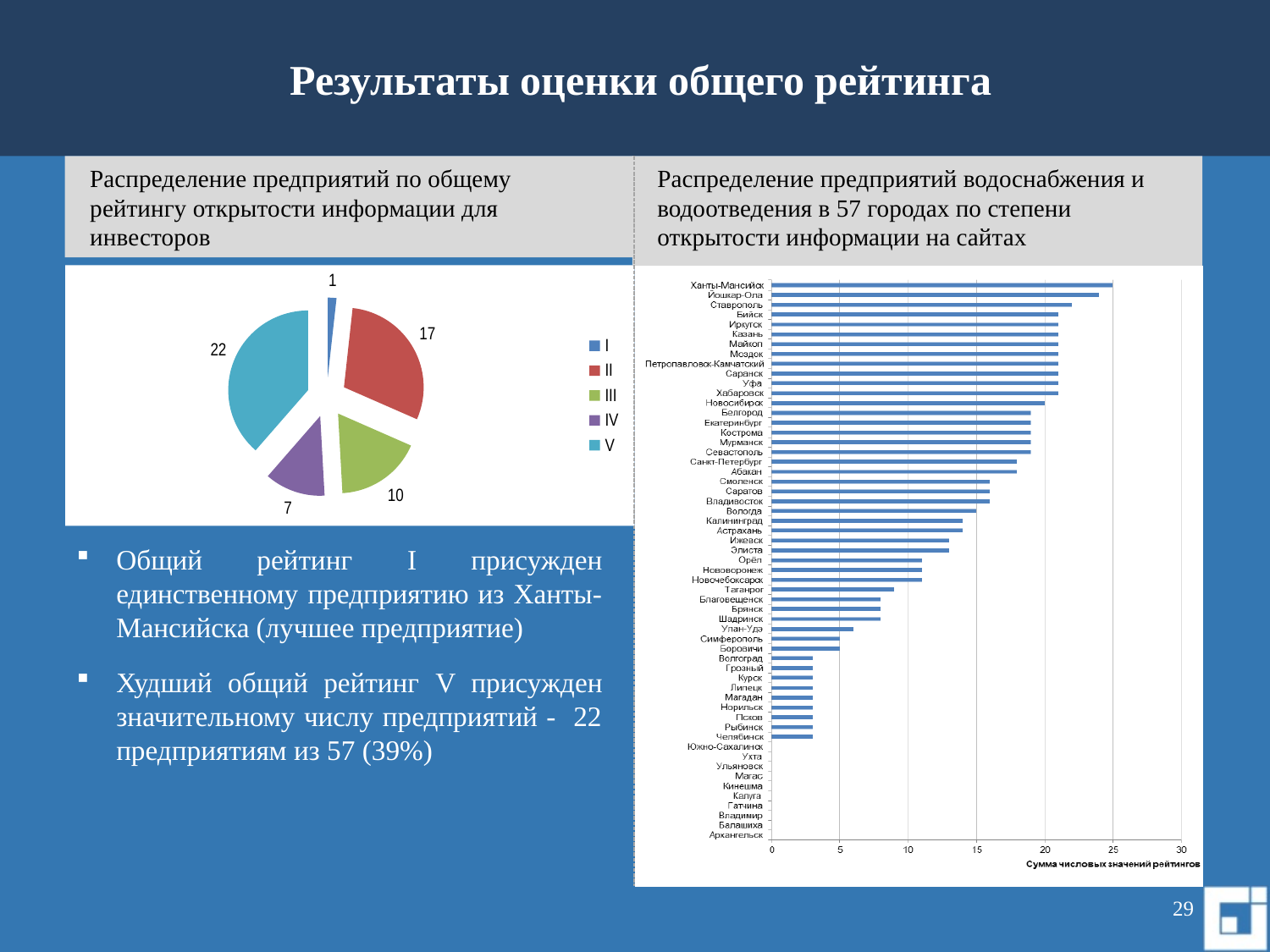
In the pie chart on the left, which category has the smallest value? I In the pie chart on the left, what is the value for category II? 17 In the bar chart on the right, which city has the highest value? Ханты-Мансийск In the pie chart on the left, how many categories does the legend list? 5 In the pie chart on the left, what is the difference between the values for category V and category II? 5 In the pie chart on the left, which category has the largest value? V In the pie chart on the left, what is the value for category V? 22 What kind of chart is shown on the right side of the slide? Bar chart In the pie chart on the left, what is the total of all slice values? 57 In the pie chart on the left, which is larger, the value for category III or category IV? III In the bar chart on the right, is the value for Йошкар-Ола greater or less than 20? greater In the bar chart on the right, is the value for Волгоград greater or less than 5? less